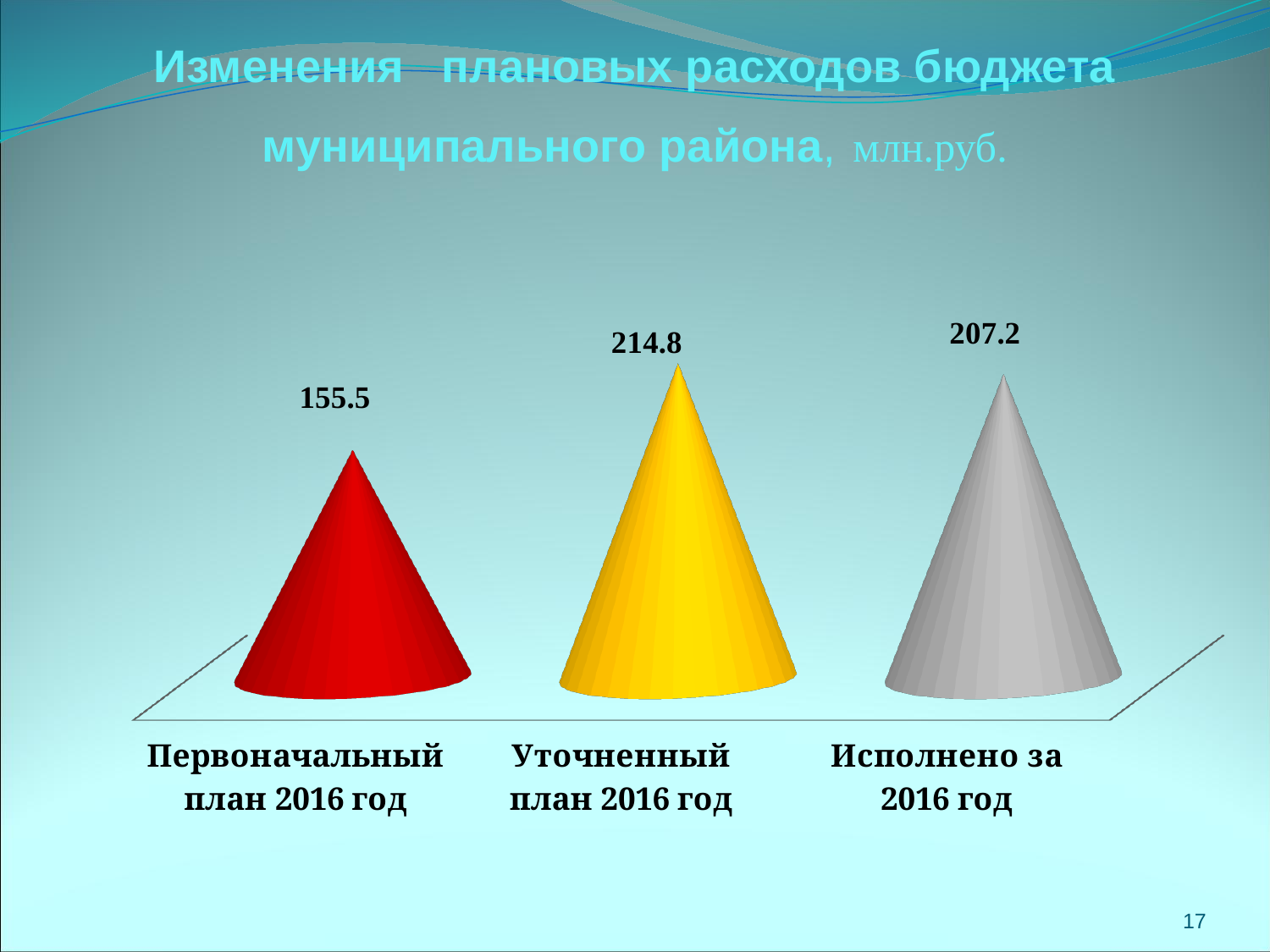
What is the difference between Уточненный план 2016 год and Первоначальный план 2016 год? 59.3 What is the value for Исполнено за 2016 год? 207.2 Which category has the highest value? Уточненный план 2016 год How many categories are shown in the chart? 3 What is the difference between Уточненный план 2016 год and Исполнено за 2016 год? 7.6 What unit of measurement is given in the chart title? млн.руб. What is the value for Первоначальный план 2016 год? 155.5 What kind of chart is shown on the slide? bar chart What is the value for Уточненный план 2016 год? 214.8 Which category has the lowest value? Первоначальный план 2016 год What colour is the bar for Уточненный план 2016 год? yellow Which is larger: Исполнено за 2016 год or Первоначальный план 2016 год? Исполнено за 2016 год